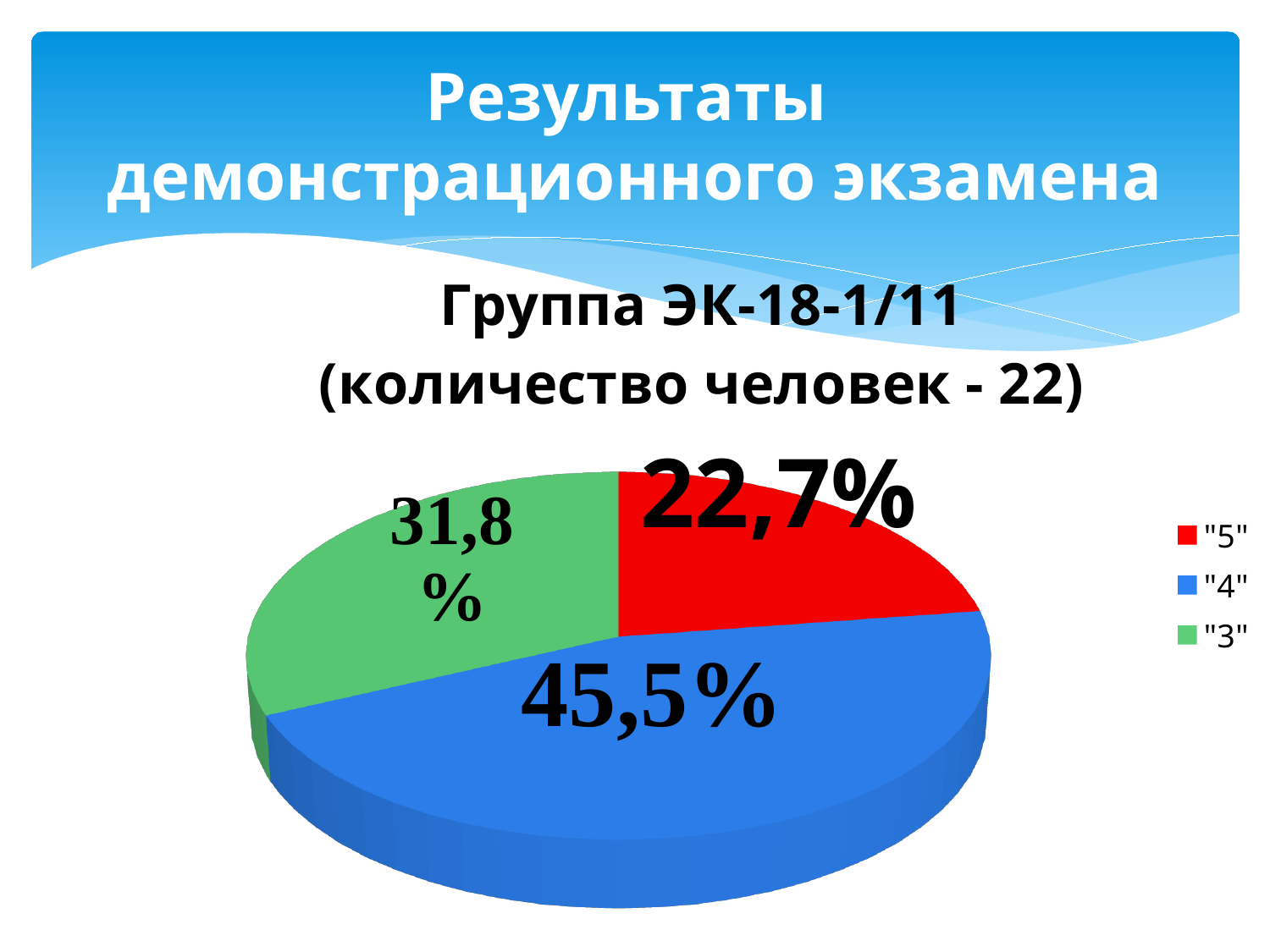
How many slices does the pie chart have? 3 Which slice is larger, "3" or "5"? "3" What kind of chart is shown on the slide? Pie chart What colour is the "5" slice in the pie chart? Red How many entries does the legend list? 3 What share of the pie does the "5" slice represent? 22,7% What share of the pie does the "3" slice represent? 31,8% Which grade has the largest slice of the pie? "4" What is the difference in percentage points between the "4" slice and the "5" slice? 22,8 What share of the pie does the "4" slice represent? 45,5% What is the difference in percentage points between the "3" slice and the "5" slice? 9,1 Which grade has the smallest slice of the pie? "5"